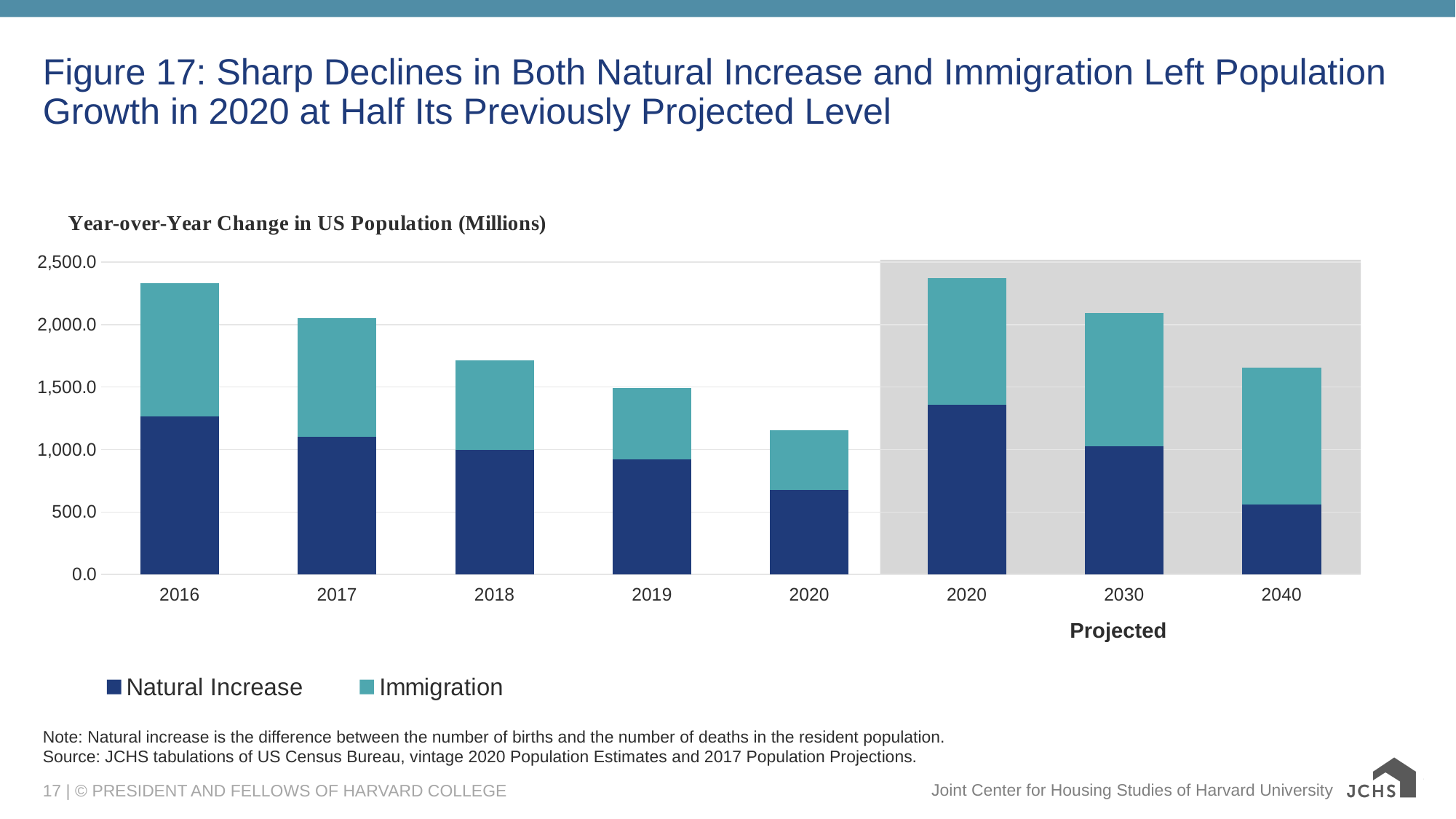
Which year has the lowest total year-over-year population change? 2020 (actual) Which is larger, the total bar for 2016 or the total bar for the actual 2020? 2016 Which bar has the smallest Natural Increase segment? 2040 Is the total bar for 2016 greater or less than 2,000.0? greater Do the total bars rise or fall from 2016 through the actual 2020? fall Is the total bar for 2040 greater or less than 1,500.0? greater What kind of chart is shown on the slide? Stacked bar chart Is the Natural Increase value for 2019 greater or less than 1,000.0? less How many series does the legend list? 2 How many bars are plotted in the chart? 8 What is the title of the chart? Year-over-Year Change in US Population (Millions)